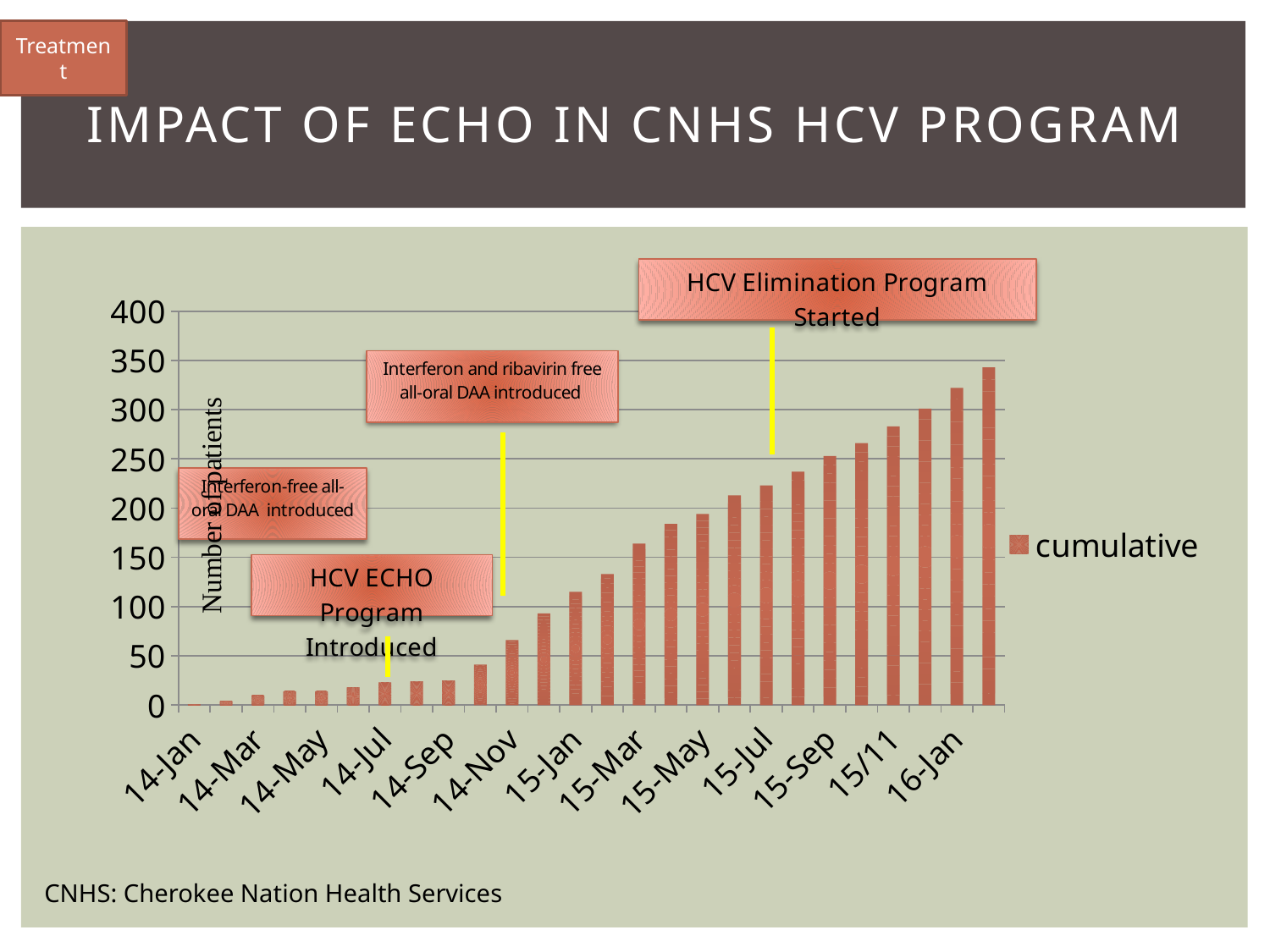
Do the values rise or fall from 14-Jan to 16-Jan? rise How many series does the legend list? 1 Is the value for 14-Sep greater or less than 50? less Which month has the lowest cumulative number of patients? 14-Jan Is the value for 16-Jan greater or less than 300? greater Is the value for 14-Nov greater or less than 100? less What is the name of the series shown in the legend? cumulative Which is larger, the value for 15-Mar or the value for 14-Nov? 15-Mar What is the label of the vertical axis? Number of patients What kind of chart is shown on the slide? bar chart